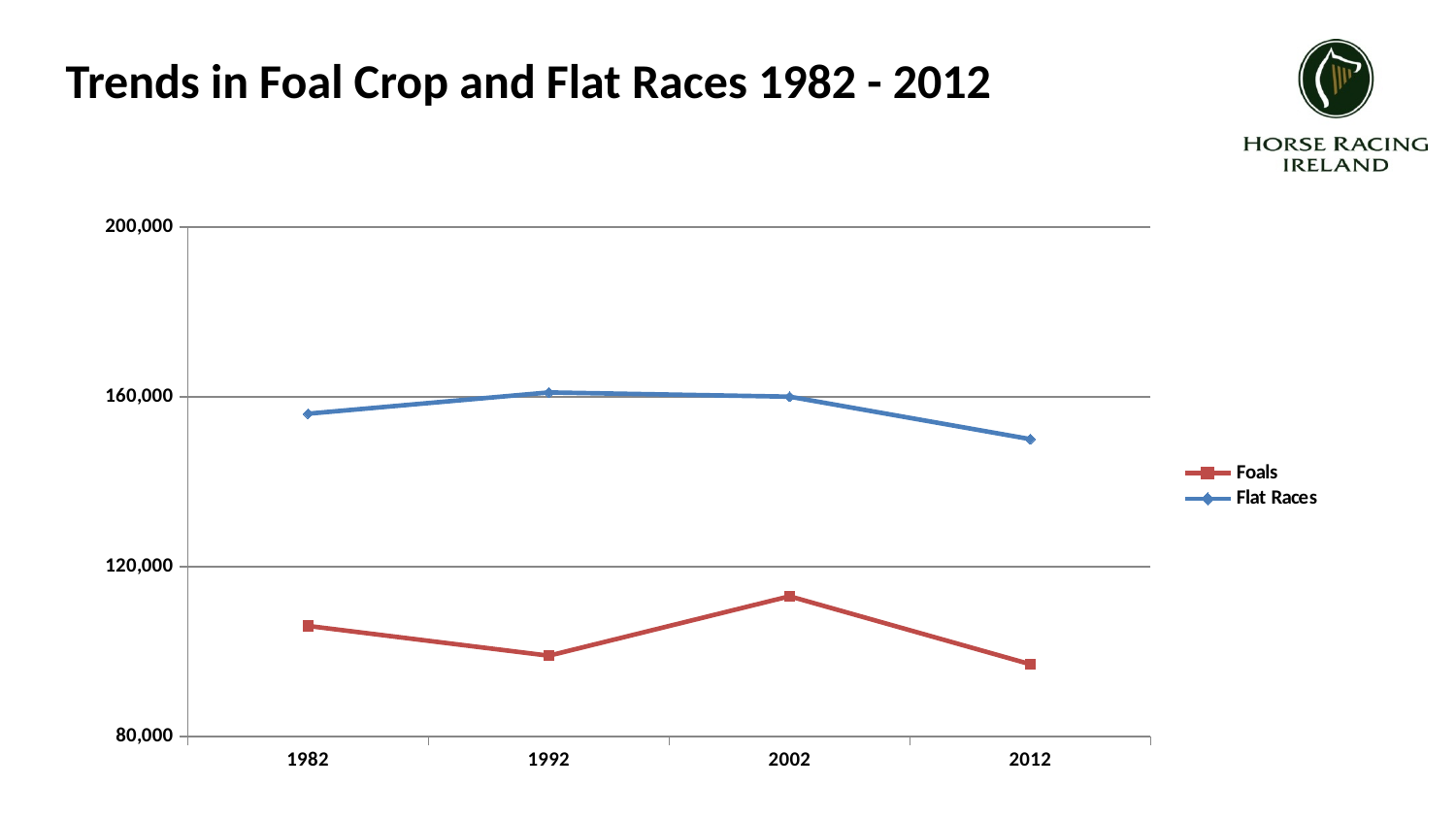
How many series does the legend list? 2 How many years are plotted along the x axis? 4 Is the Flat Races value for 2012 greater or less than 140,000? greater What is the title of the chart? Trends in Foal Crop and Flat Races 1982 - 2012 In which year is the Flat Races value lowest? 2012 Which series is drawn in red? Foals Is the Flat Races value for 1982 greater or less than 160,000? less Which series has the larger value in 2012, Foals or Flat Races? Flat Races What kind of chart is shown on the slide? line chart Is the Foals value for 2002 greater or less than 120,000? less In which year is the Foals value highest? 2002 Does the Flat Races series rise or fall from 2002 to 2012? fall